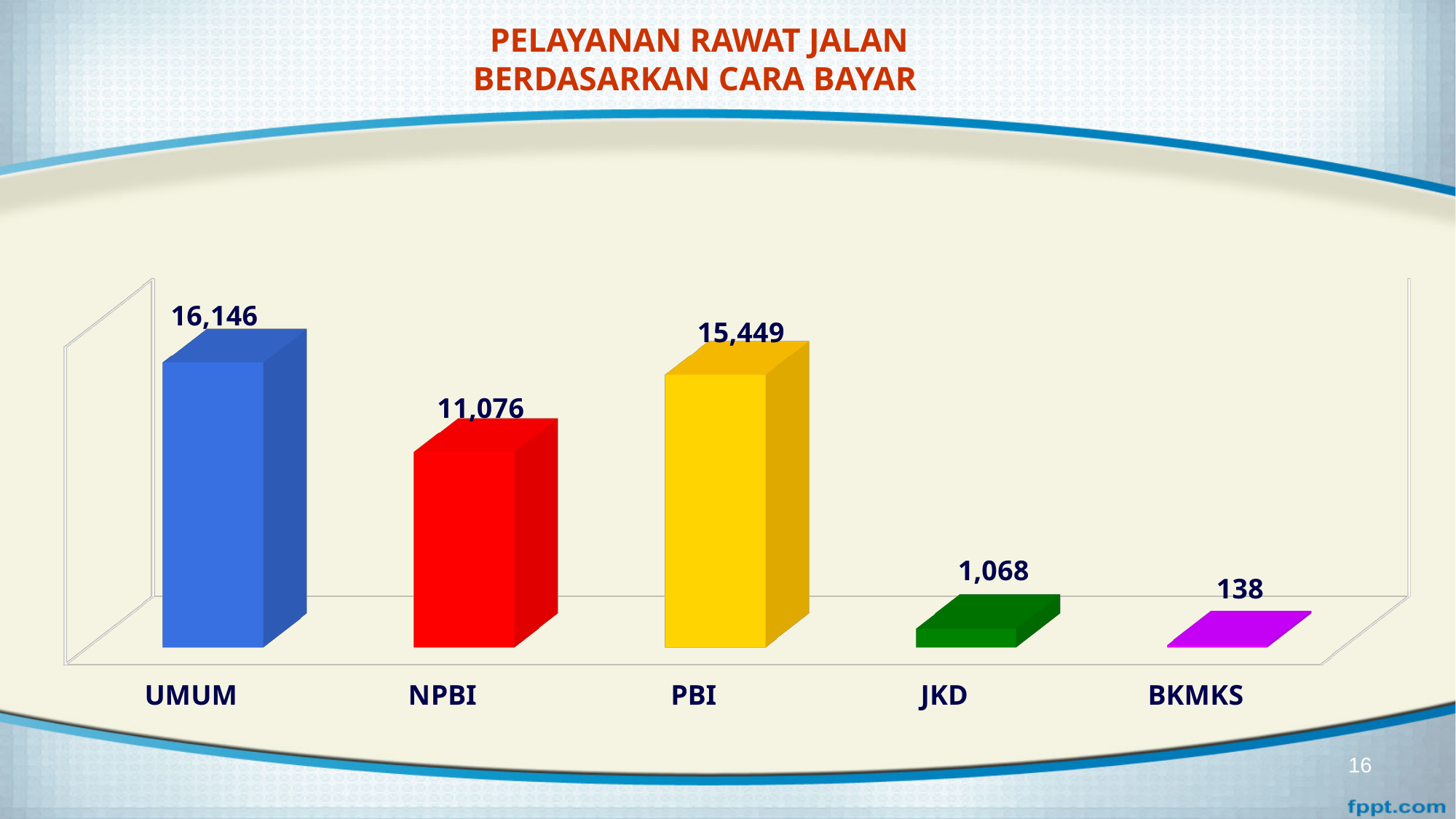
What is the value for NPBI? 11,076 Which is larger, the value for NPBI or the value for PBI? PBI Which category has the lowest value? BKMKS What kind of chart is shown on the slide? Bar chart What is the difference between the values for JKD and BKMKS? 930 What is the value for BKMKS? 138 What is the difference between the values for UMUM and PBI? 697 Which category has the highest value? UMUM How many categories are shown in the chart? 5 What is the value for UMUM? 16,146 What is the value for JKD? 1,068 What is the value for PBI? 15,449